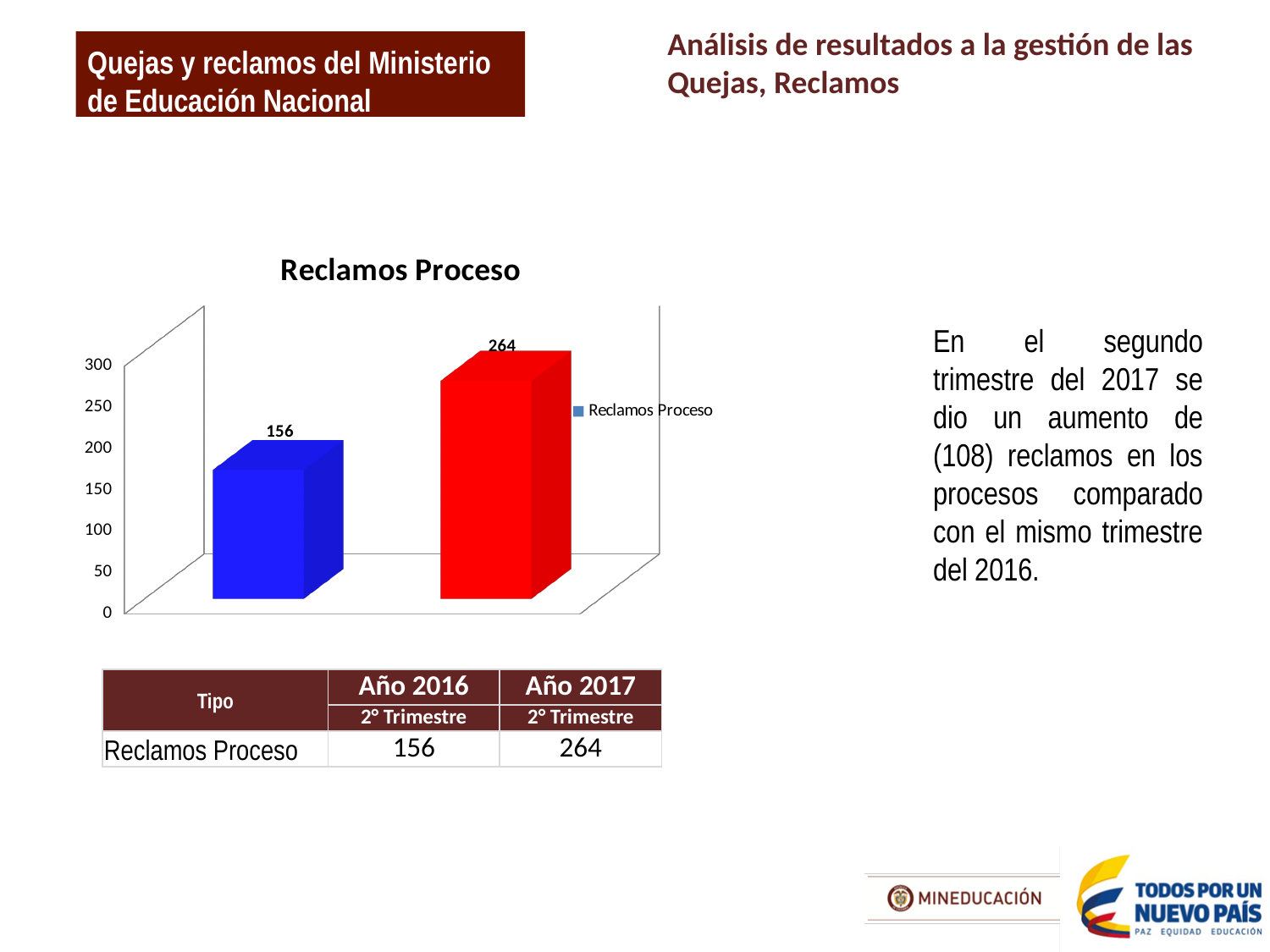
According to the table, how many Reclamos Proceso were there in the 2° Trimestre of Año 2017? 264 What type of chart is shown on the slide? bar chart How many series does the chart legend list? 1 Is the value of the red bar greater or less than 250? greater How many bars are plotted in the chart? 2 What is the value shown on the right (red) bar of the chart? 264 Which bar in the chart has the higher value, the blue one or the red one? the red one Do the values rise or fall from the left bar to the right bar? rise What is the difference between the two bar values in the chart? 108 What is the value shown on the left (blue) bar of the chart? 156 What is the title of the chart? Reclamos Proceso According to the table, how many Reclamos Proceso were there in the 2° Trimestre of Año 2016? 156